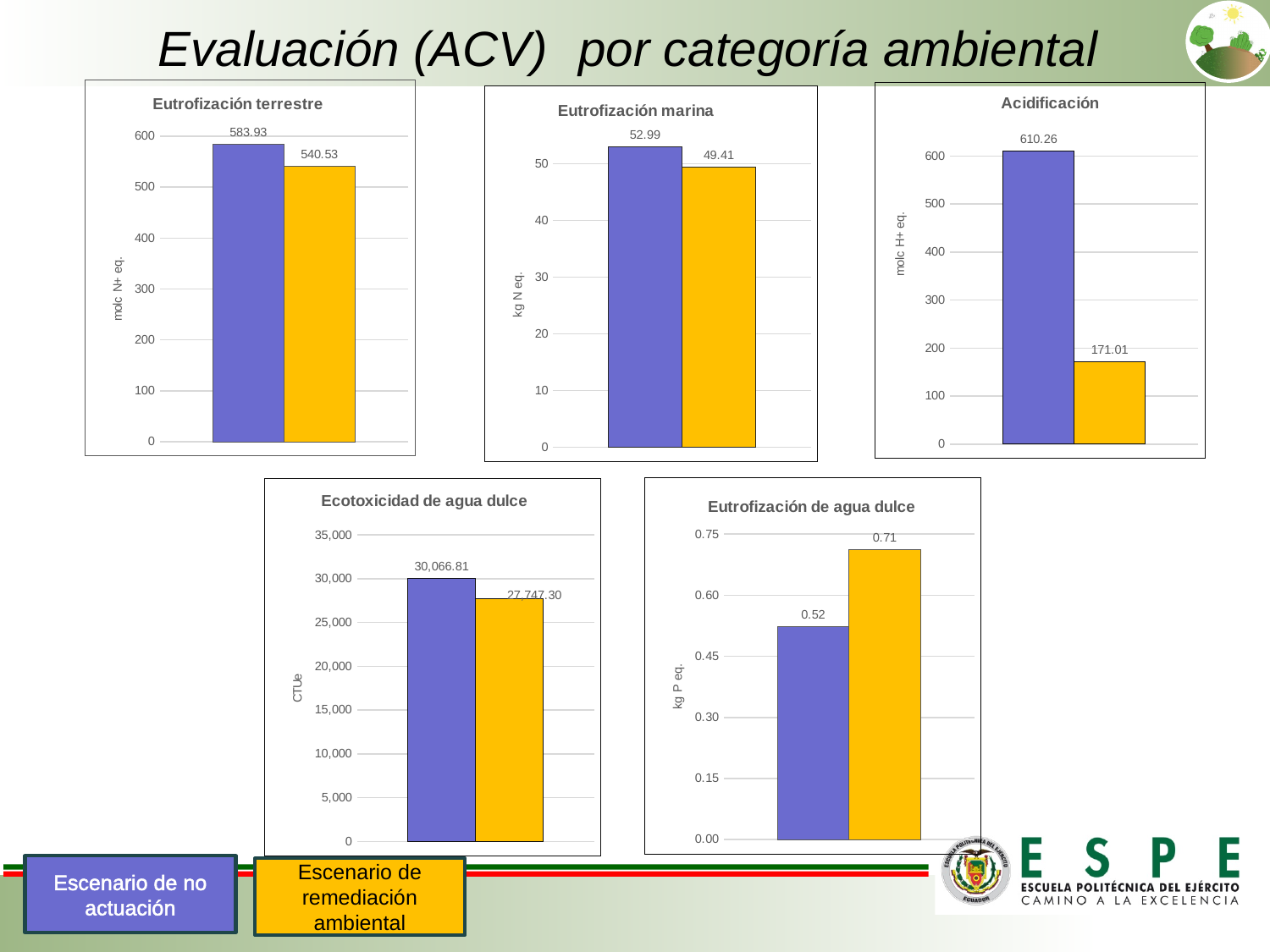
What is the y-axis unit label of the 'Ecotoxicidad de agua dulce' chart? CTUe In the 'Eutrofización de agua dulce' chart, which scenario has the higher value? Escenario de remediación ambiental In the 'Eutrofización marina' chart, what is the difference between the two bars? 3.58 In the 'Acidificación' chart, what is the difference between the 'Escenario de no actuación' and 'Escenario de remediación ambiental' values? 439.25 In the 'Eutrofización terrestre' chart, what is the value for the 'Escenario de remediación ambiental' (yellow) bar? 540.53 How many charts are shown on the slide? 5 In the 'Eutrofización terrestre' chart, what is the value for the 'Escenario de no actuación' (blue) bar? 583.93 In the 'Ecotoxicidad de agua dulce' chart, what is the value for the 'Escenario de no actuación' (blue) bar? 30,066.81 In the 'Eutrofización marina' chart, what is the value for the 'Escenario de remediación ambiental' (yellow) bar? 49.41 In the 'Eutrofización de agua dulce' chart, what is the value for the 'Escenario de remediación ambiental' (yellow) bar? 0.71 In the 'Acidificación' chart, what is the value for the 'Escenario de no actuación' (blue) bar? 610.26 What type of chart is the 'Acidificación' chart? Bar chart